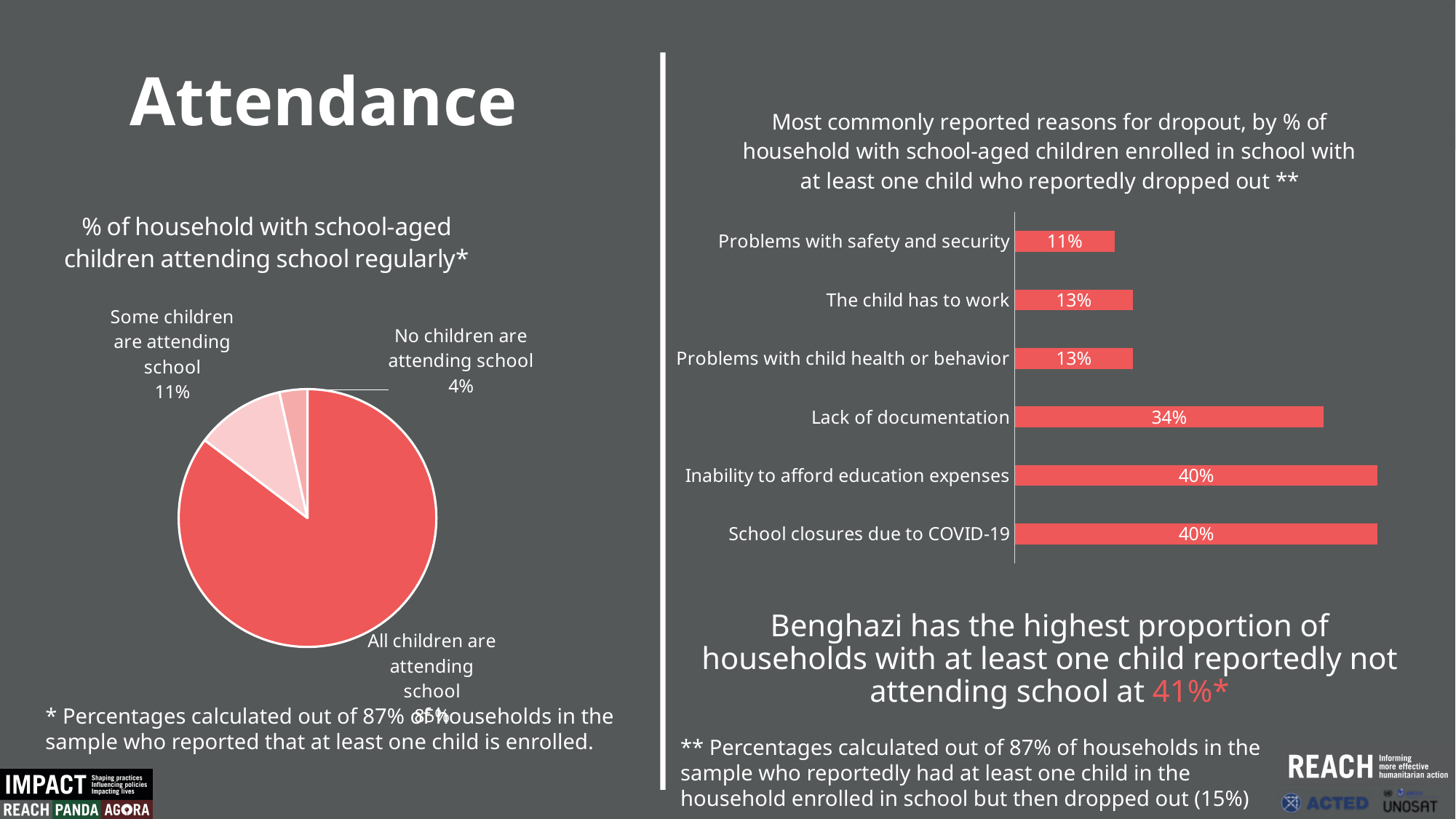
On the bar chart of reasons for dropout, what percentage is shown for Problems with safety and security? 11% On the bar chart of reasons for dropout, how many reasons are listed? 6 On the bar chart of reasons for dropout, what percentage is shown for School closures due to COVID-19? 40% On the bar chart of reasons for dropout, what is the difference between Inability to afford education expenses and Lack of documentation? 6% On the pie chart of households with school-aged children attending school regularly, which category has the largest slice? All children are attending school On the pie chart of households with school-aged children attending school regularly, what percentage is shown for 'No children are attending school'? 4% What kind of chart is the chart on the right side of the slide showing reasons for dropout? Bar chart What kind of chart is the chart on the left side of the slide? Pie chart On the pie chart of households with school-aged children attending school regularly, what percentage is shown for 'Some children are attending school'? 11% On the bar chart of reasons for dropout, what percentage is shown for Lack of documentation? 34% On the bar chart of reasons for dropout, which is larger: Lack of documentation or The child has to work? Lack of documentation On the bar chart of reasons for dropout, which reason has the lowest percentage? Problems with safety and security